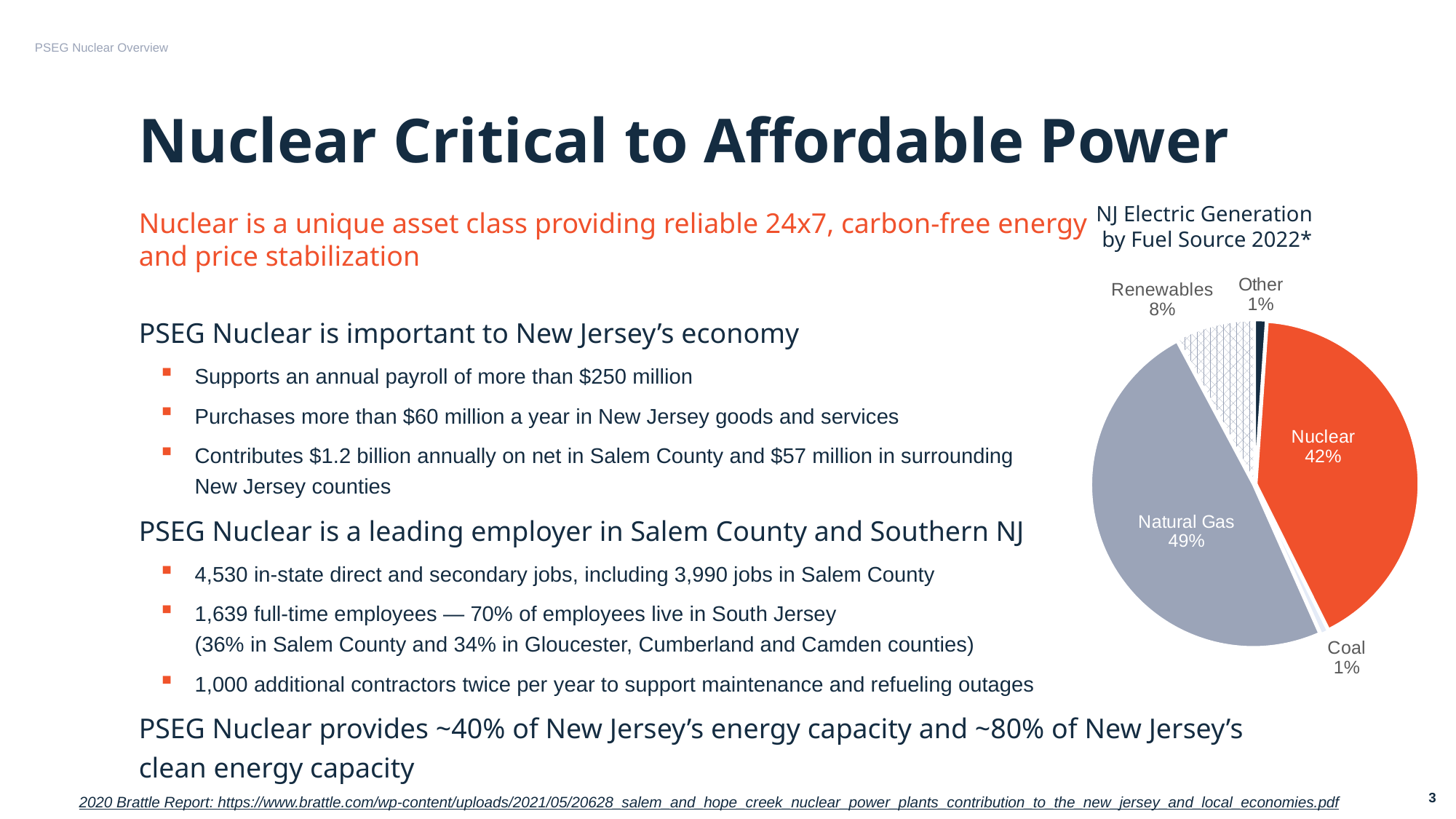
How many fuel source categories are shown in the pie chart? 5 What share of NJ electric generation by fuel source in 2022 comes from Coal? 1% What share of NJ electric generation by fuel source in 2022 comes from Nuclear? 42% What kind of chart is used to show NJ electric generation by fuel source in 2022? Pie chart What share of NJ electric generation by fuel source in 2022 comes from Renewables? 8% What is the difference in share between Natural Gas and Nuclear in the NJ electric generation pie chart? 7% Which fuel source has the largest share of NJ electric generation in 2022? Natural Gas What is the difference in share between Renewables and Coal in the NJ electric generation pie chart? 7% What is the title of the pie chart on the slide? NJ Electric Generation by Fuel Source 2022* Which has a larger share of NJ electric generation in 2022, Nuclear or Renewables? Nuclear What colour is the Nuclear slice in the pie chart? Orange What share of NJ electric generation by fuel source in 2022 comes from Natural Gas? 49%